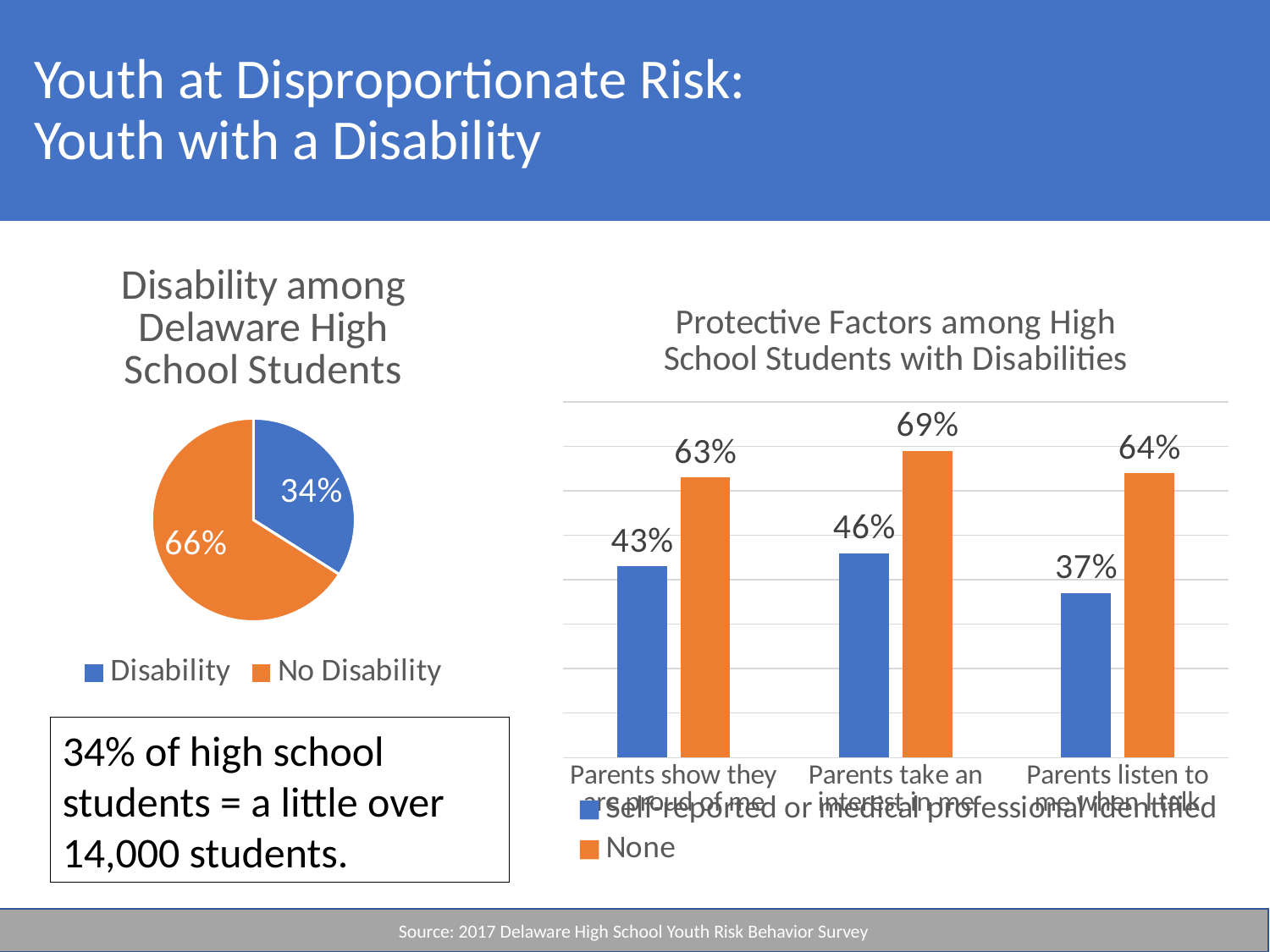
How many categories are shown on the x axis of the 'Protective Factors among High School Students with Disabilities' chart? 3 In the 'Protective Factors among High School Students with Disabilities' chart, which is larger for 'Parents show they are proud of me': the 'None' value or the 'Self-reported or medical professional identified' value? None How many series does the legend of the 'Protective Factors among High School Students with Disabilities' chart list? 2 In the 'Disability among Delaware High School Students' chart, what share of the pie is 'No Disability'? 66% In the 'Protective Factors among High School Students with Disabilities' chart, what is the value for 'Parents listen to me when I talk' for the 'Self-reported or medical professional identified' series? 37% In the 'Protective Factors among High School Students with Disabilities' chart, what is the difference between the 'None' and 'Self-reported or medical professional identified' values for 'Parents listen to me when I talk'? 27% In the 'Protective Factors among High School Students with Disabilities' chart, which category has the highest value for the 'Self-reported or medical professional identified' series? Parents take an interest in me What kind of chart is 'Disability among Delaware High School Students'? Pie chart In the 'Disability among Delaware High School Students' chart, what percentage of students have a disability? 34% What kind of chart is 'Protective Factors among High School Students with Disabilities'? Bar chart In the 'Protective Factors among High School Students with Disabilities' chart, what is the value for 'Parents take an interest in me' for the 'None' series? 69% In the 'Protective Factors among High School Students with Disabilities' chart, which category has the lowest value for the 'None' series? Parents show they are proud of me